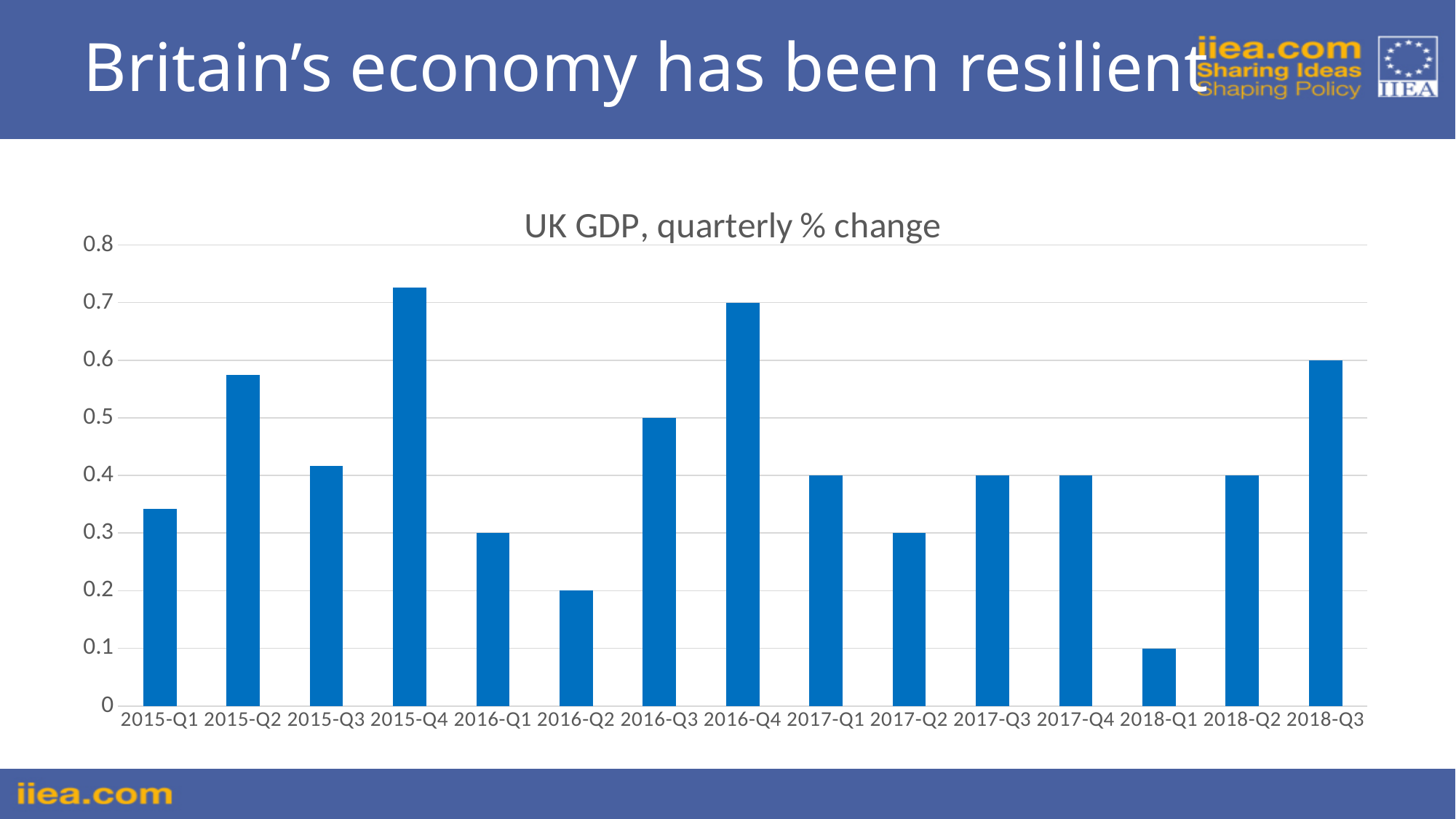
Which quarter has the highest quarterly % change? 2015-Q4 Which quarter has the lowest quarterly % change? 2018-Q1 What is the quarterly % change for 2016-Q2? 0.2 What is the quarterly % change for 2018-Q1? 0.1 How many quarters are plotted on the chart? 15 Which is larger, the value for 2016-Q3 or the value for 2017-Q2? 2016-Q3 What is the title of the chart? UK GDP, quarterly % change Is the value for 2015-Q2 greater or less than 0.5? greater What is the difference between the values for 2016-Q4 and 2016-Q2? 0.5 What kind of chart is shown on the slide? bar chart What is the quarterly % change for 2018-Q3? 0.6 What is the quarterly % change for 2016-Q4? 0.7